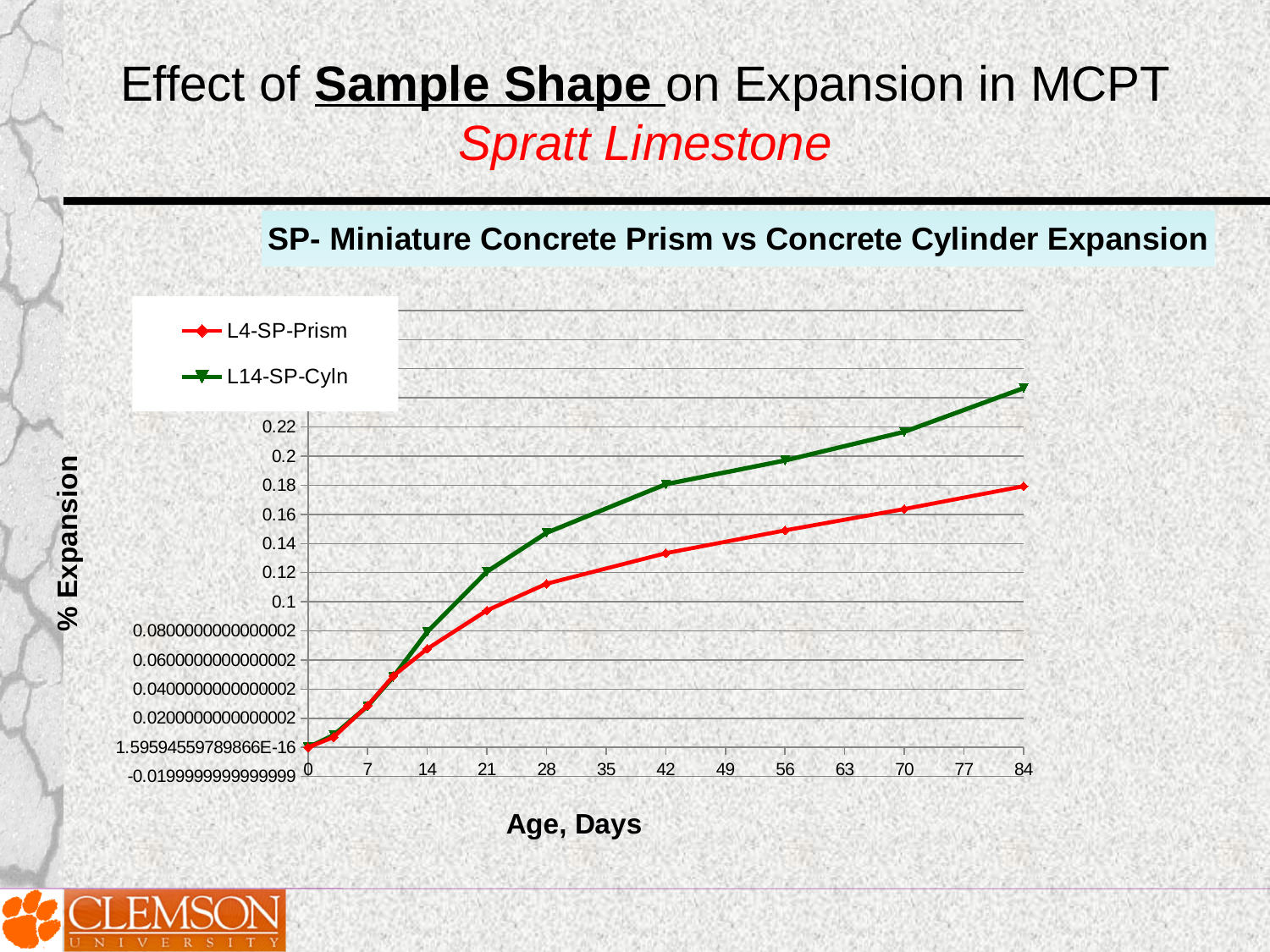
Which series has the higher value at 42 days, L4-SP-Prism or L14-SP-Cyln? L14-SP-Cyln Do the values for L4-SP-Prism rise or fall as age increases from 0 to 84 days? rise How many series does the legend list? 2 Is the value for L14-SP-Cyln at 84 days greater or less than 0.22? greater What is the label of the x axis? Age, Days Is the value for L4-SP-Prism at 21 days greater or less than 0.1? less Which series has the higher value at 84 days, L4-SP-Prism or L14-SP-Cyln? L14-SP-Cyln Is the value for L4-SP-Prism at 42 days greater or less than 0.12? greater Do the values for L14-SP-Cyln rise or fall as age increases from 0 to 84 days? rise What kind of chart is shown on the slide? line chart What is the title of the chart? SP- Miniature Concrete Prism vs Concrete Cylinder Expansion